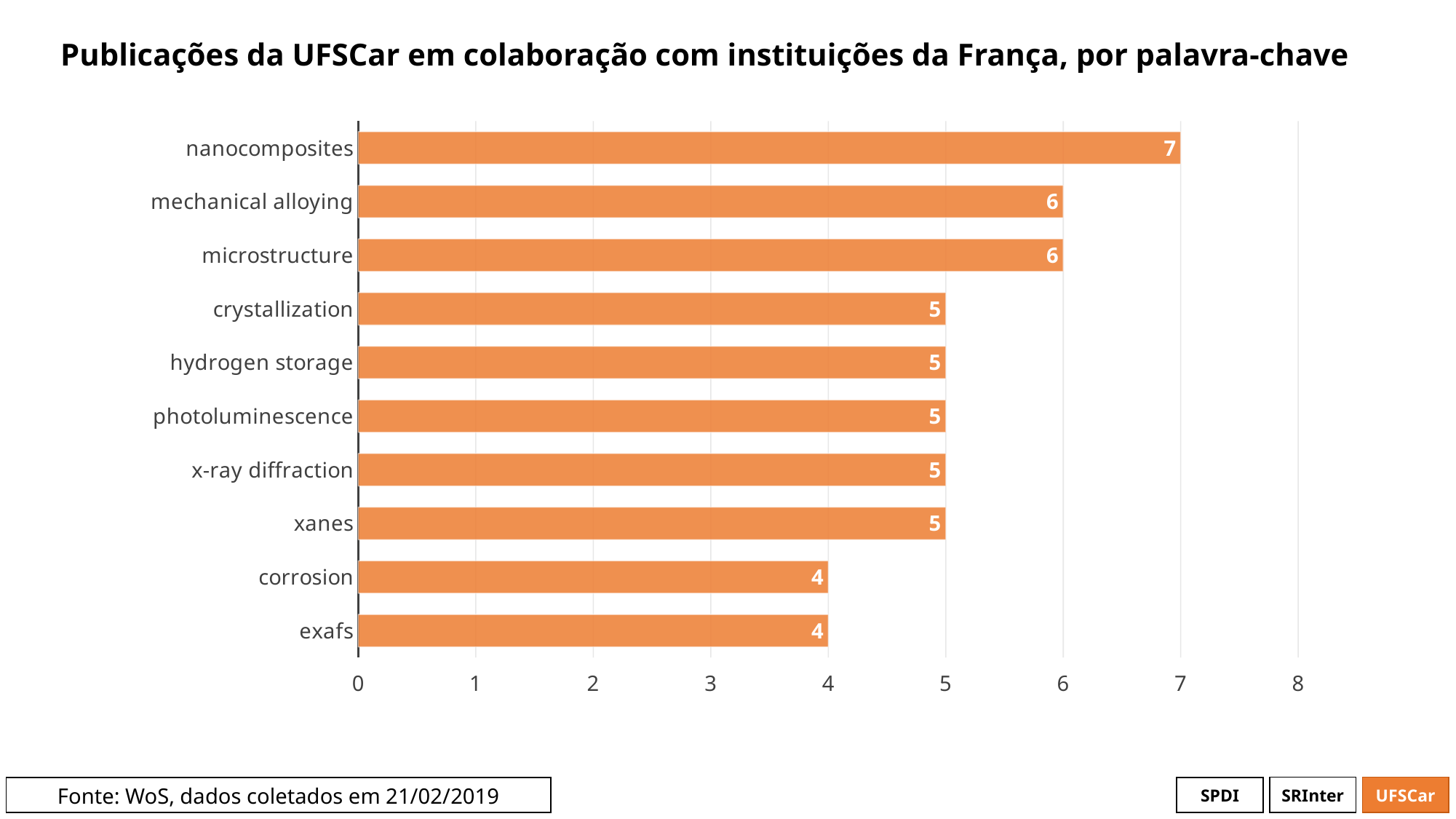
What is the value for photoluminescence? 5 What is the value for corrosion? 4 How many keywords are shown in the chart? 10 What is the value for mechanical alloying? 6 What is the difference between the values for nanocomposites and exafs? 3 What is the title of the chart? Publicações da UFSCar em colaboração com instituições da França, por palavra-chave What kind of chart is shown on the slide? bar chart Which keyword has the highest value? nanocomposites What is the value for nanocomposites? 7 What is the difference between the values for microstructure and crystallization? 1 Is the value for hydrogen storage greater or less than 4? greater Which is larger, the value for mechanical alloying or the value for xanes? mechanical alloying